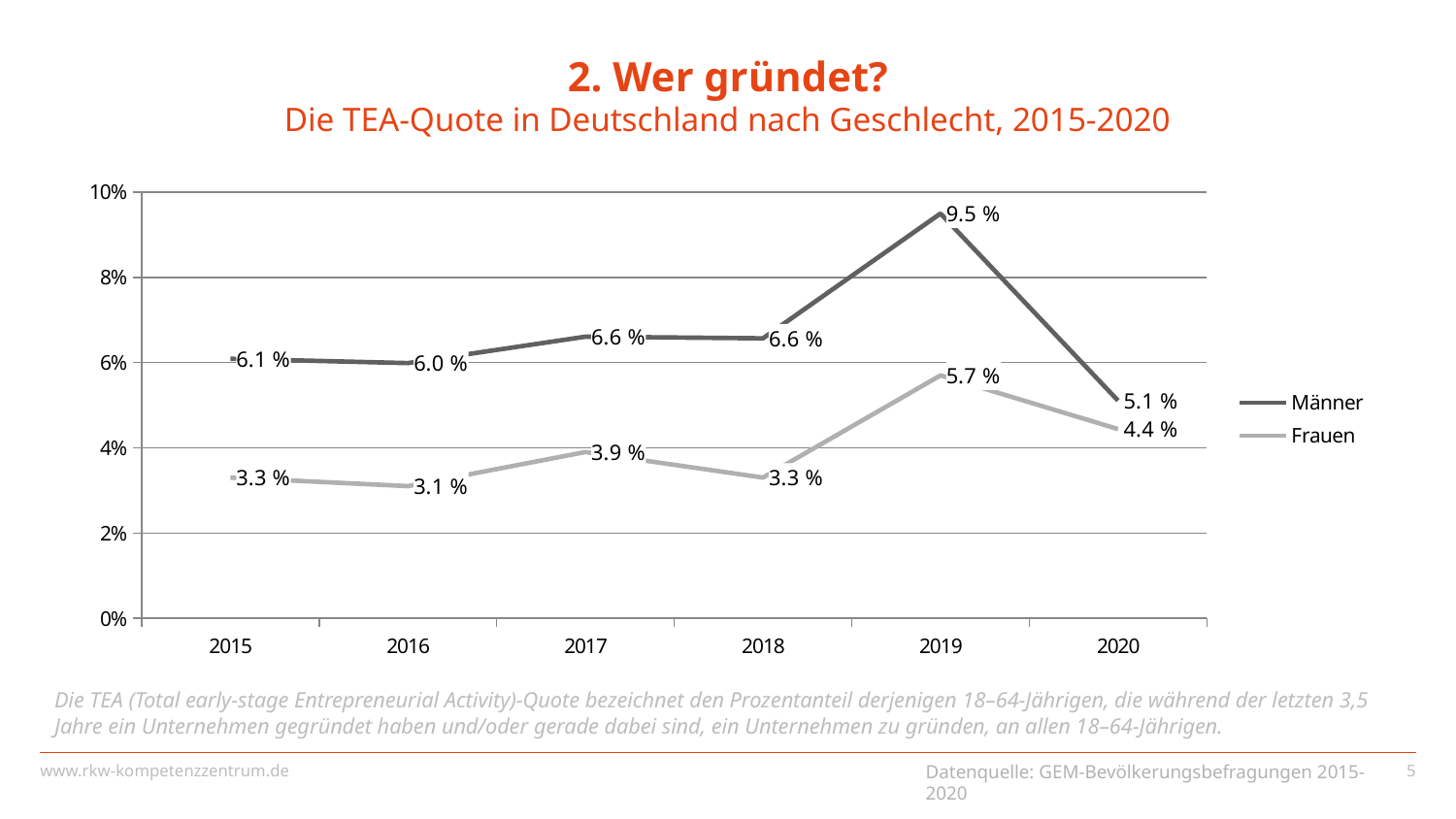
What is the TEA rate for Männer in 2019? 9.5 % In which year is the TEA rate for Männer highest? 2019 What is the TEA rate for Frauen in 2016? 3.1 % Does the Männer TEA rate rise or fall from 2019 to 2020? fall Is the Männer TEA rate in 2018 greater or less than 8%? less In which year is the TEA rate for Frauen lowest? 2016 What is the difference between the Männer and Frauen TEA rates in 2019? 3.8 % How many years are shown on the x axis? 6 What kind of chart is shown on the slide? line chart How many series does the legend list? 2 Which is larger, the Männer TEA rate in 2020 or the Frauen TEA rate in 2019? Frauen TEA rate in 2019 What is the TEA rate for Frauen in 2020? 4.4 %